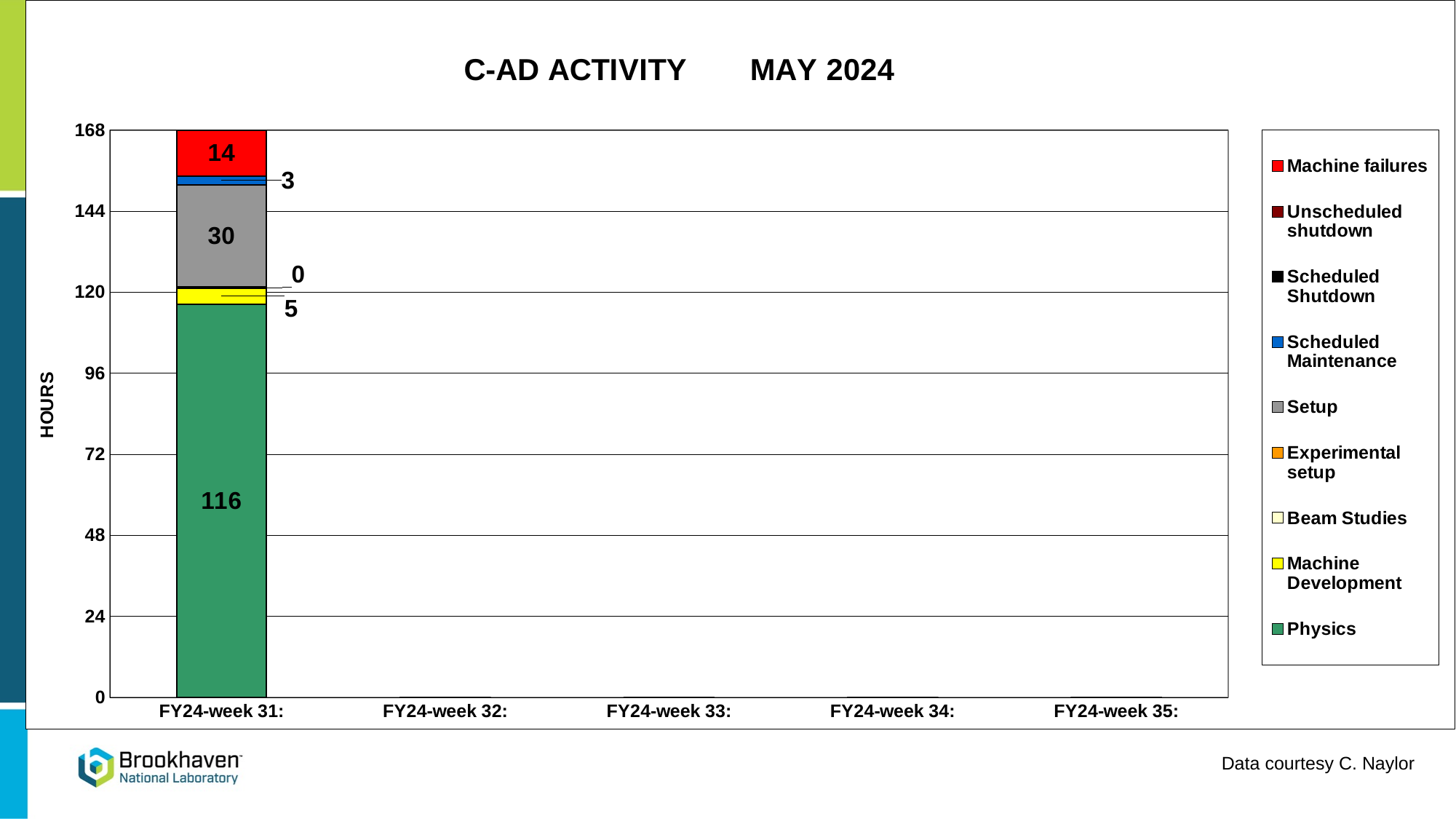
Which is larger for FY24-week 31, Machine failures or Setup? Setup How many hours of Scheduled Maintenance are shown for FY24-week 31? 3 How many hours of Machine failures are shown for FY24-week 31? 14 What type of chart is shown on the slide? Stacked bar chart Which activity has the most hours in FY24-week 31? Physics How many week categories are shown on the x axis? 5 What is the total height of the stacked bar for FY24-week 31? 168 How many series does the legend list? 9 How many hours of Machine Development are shown for FY24-week 31? 5 How many hours of Setup are shown for FY24-week 31? 30 What is the difference between Physics hours and Setup hours in FY24-week 31? 86 How many hours of Physics are shown for FY24-week 31? 116